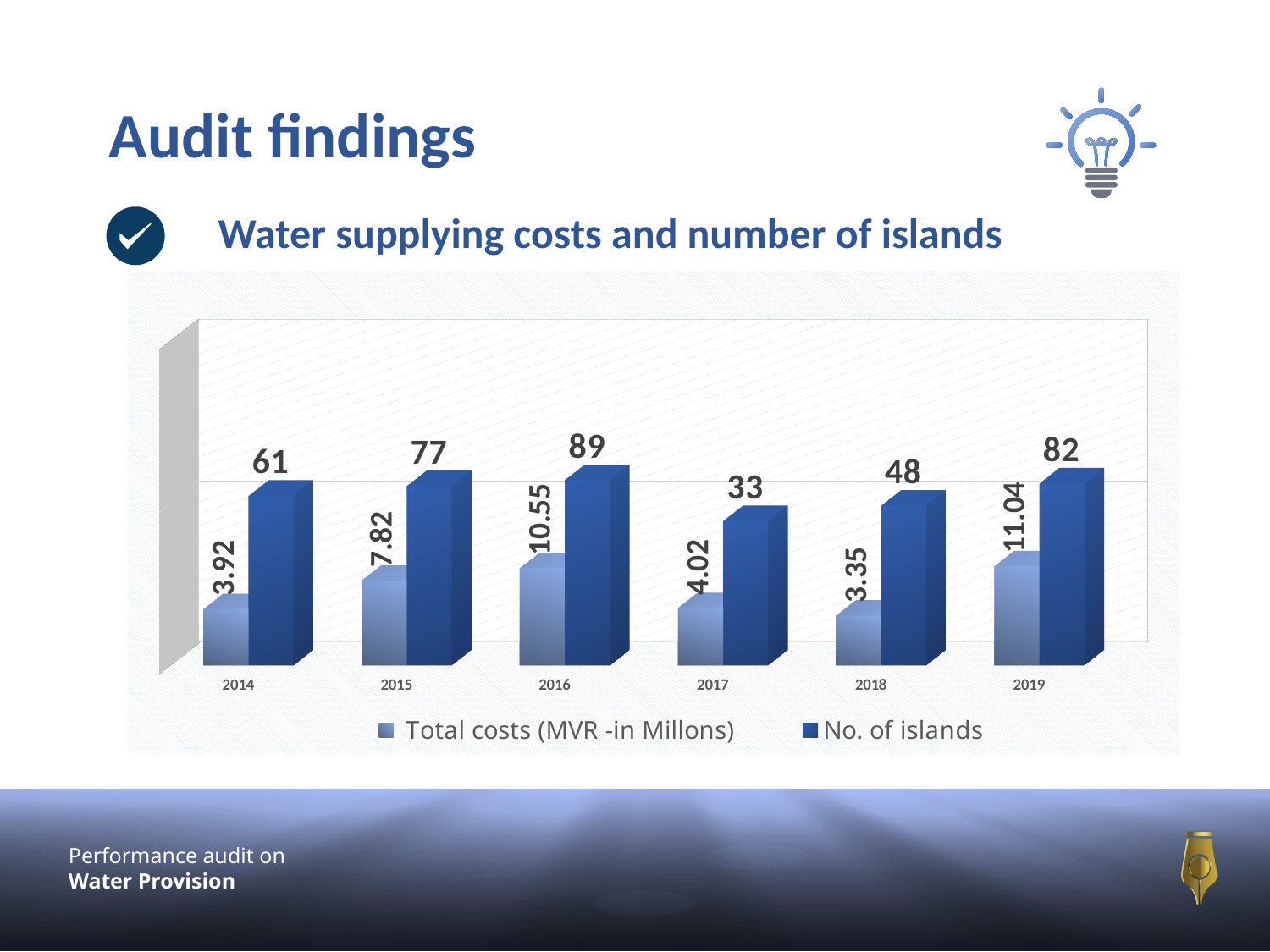
Which year has the highest No. of islands? 2016 What type of chart is shown on the slide? Bar chart Which year has the lowest Total costs (MVR - in Millions)? 2018 What is the No. of islands for 2017? 33 What is the value of Total costs (MVR - in Millions) for 2019? 11.04 How many years are shown on the x axis of the chart? 6 What is the difference in No. of islands between 2016 and 2017? 56 How many series does the chart's legend list? 2 What is the difference in Total costs (MVR - in Millions) between 2019 and 2018? 7.69 Which year has a larger No. of islands, 2015 or 2019? 2019 What is the value of Total costs (MVR - in Millions) for 2016? 10.55 Which year has the lowest No. of islands? 2017